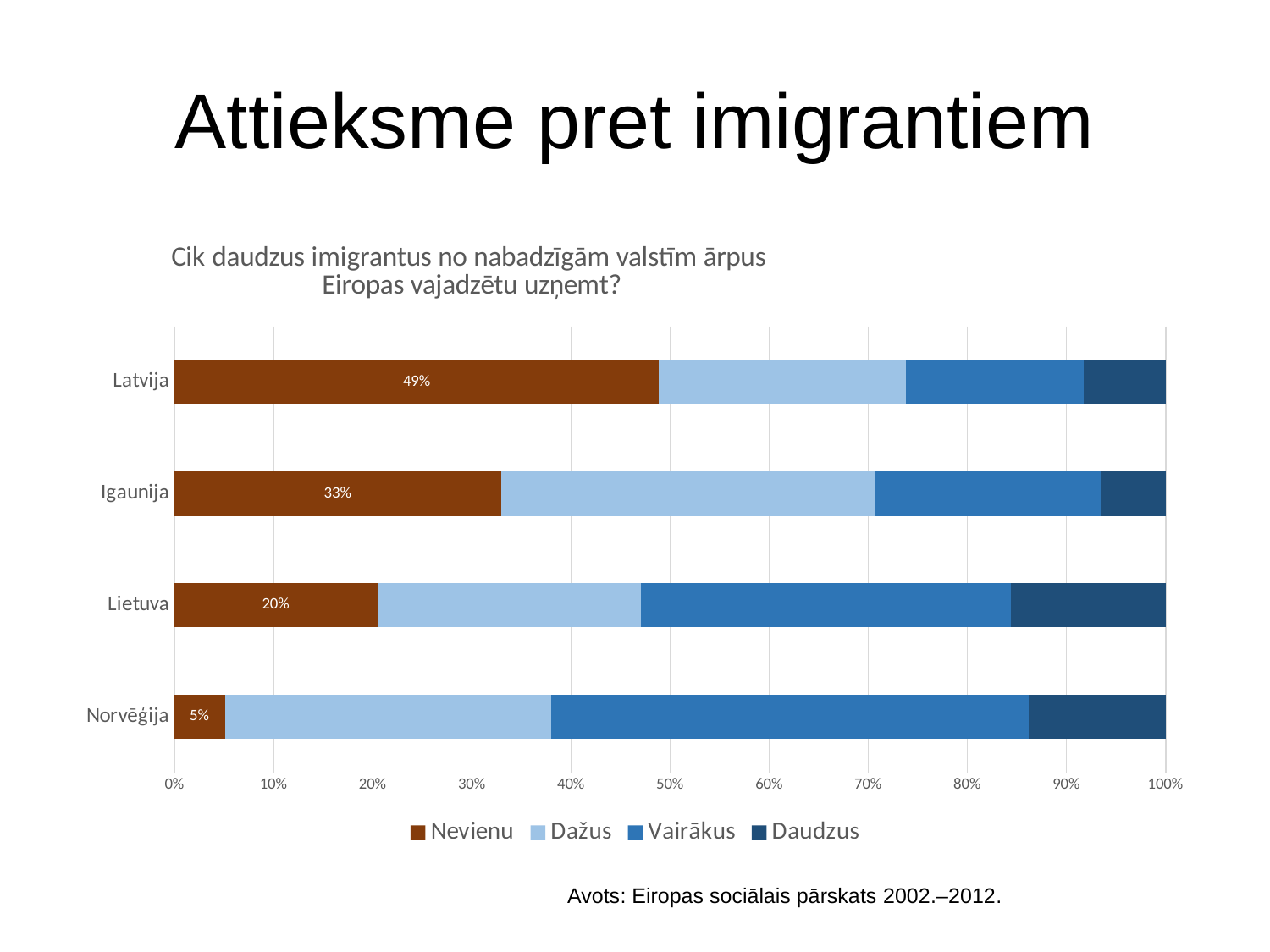
What is the "Nevienu" value for Norvēģija? 5% What is the "Nevienu" value for Latvija? 49% What kind of chart is shown on the slide? Stacked bar chart What is the "Nevienu" value for Lietuva? 20% Which country has the lowest "Nevienu" share? Norvēģija What is the "Nevienu" value for Igaunija? 33% How many countries are shown on the chart? 4 Is the "Vairākus" segment for Norvēģija greater or less than 40%? greater How many series does the legend list? 4 What is the difference between the "Nevienu" values for Latvija and Igaunija? 16% Which country has the highest "Nevienu" share? Latvija Which has a larger "Nevienu" share, Lietuva or Igaunija? Igaunija